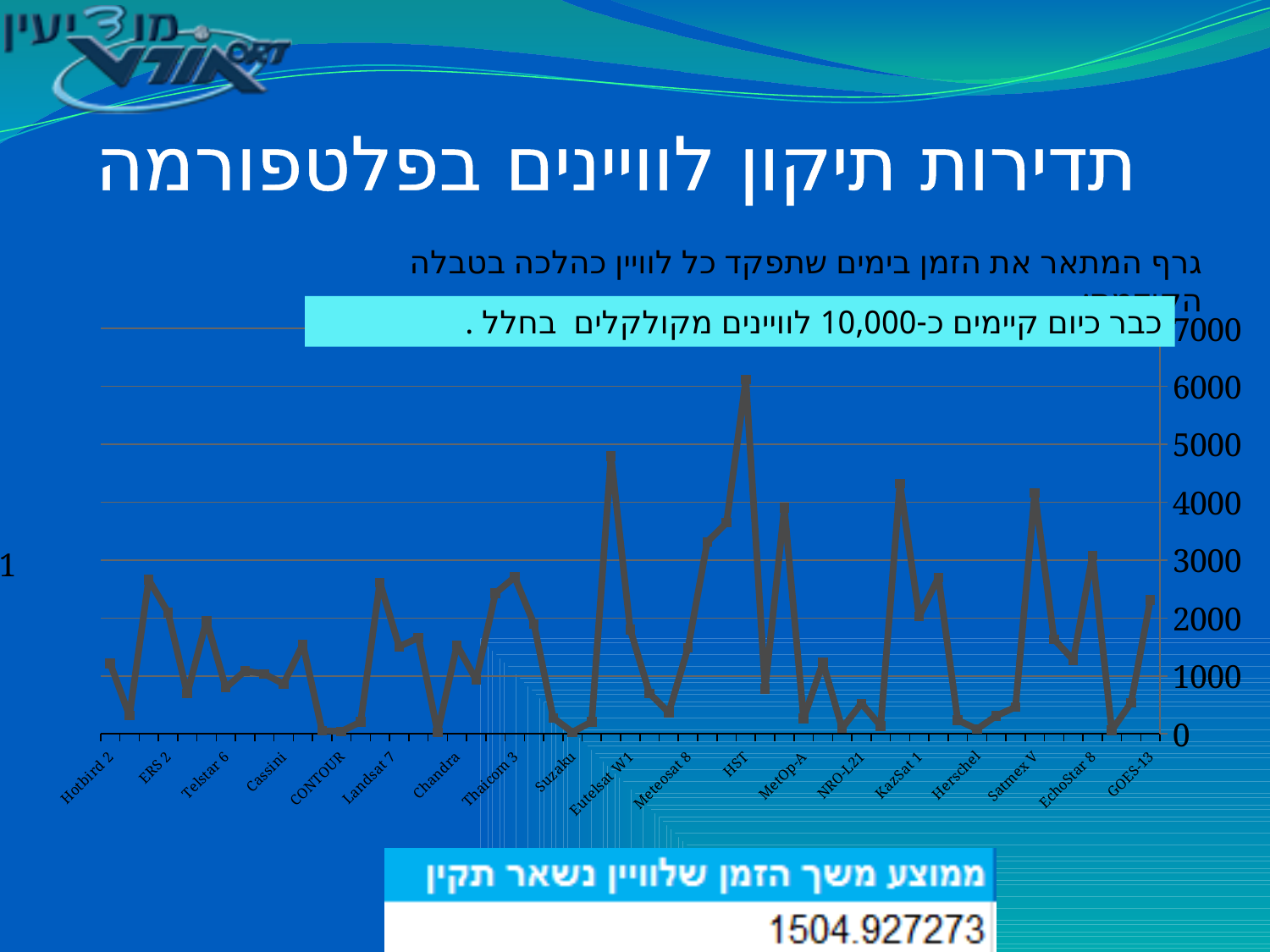
Is the value for Hotbird 2 greater or less than 1000? greater What kind of chart is shown on the slide? line chart Which has a larger value, HST or GOES-13? HST Which has a larger value, HST or Hotbird 2? HST Is the value for HST greater or less than 5000? greater Which satellite has the highest value on the chart? HST Is the value for GOES-13 greater or less than 3000? less What is the highest value shown on the vertical axis of the chart? 7000 What average value is printed in the box below the chart? 1504.927273